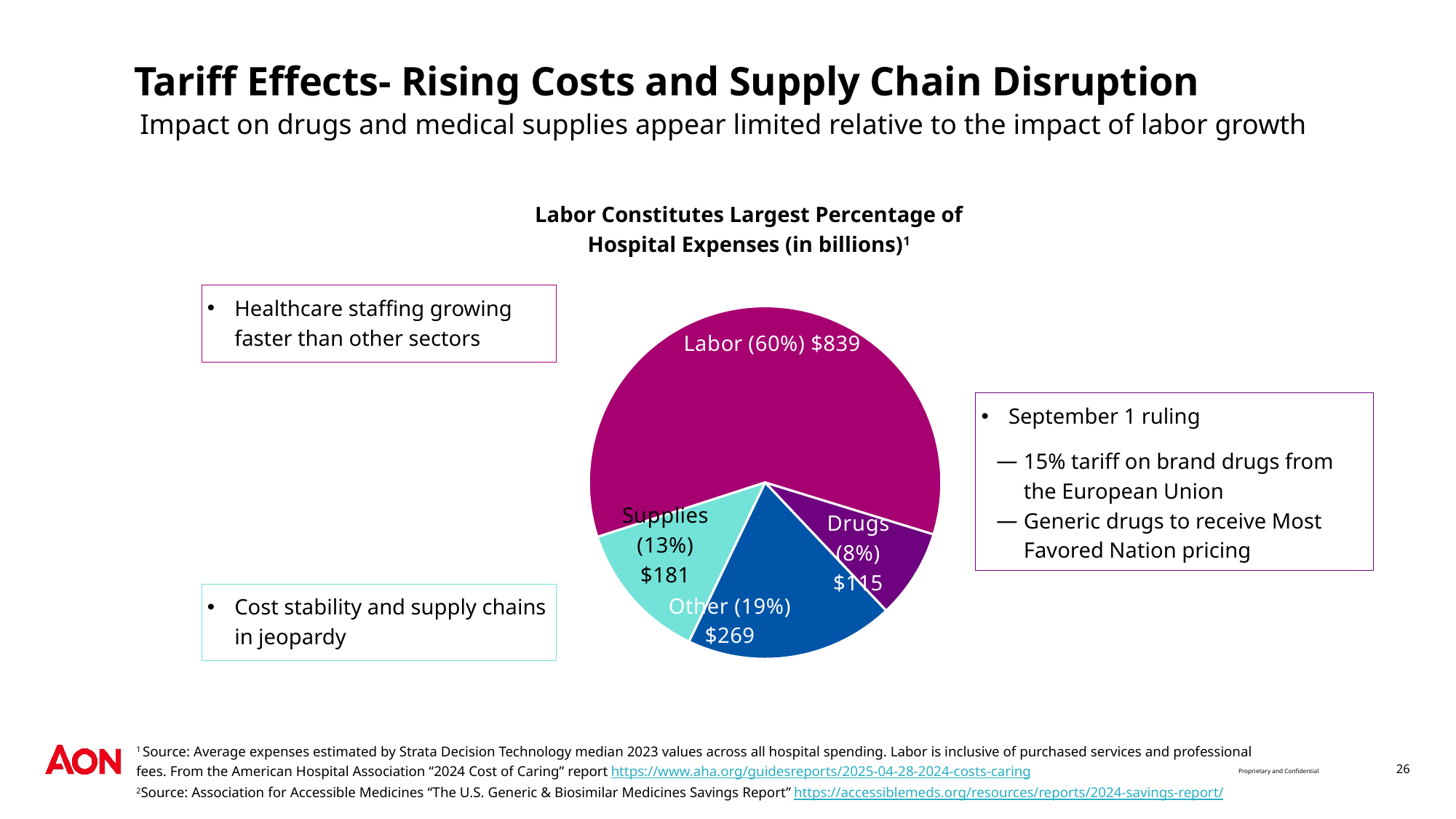
Which is larger, the value for Supplies or the value for Drugs? Supplies What share of the pie does Supplies represent? 13% What is the value for Labor in the pie chart? $839 What is the difference between the Labor value and the Other value? $570 What is the value for Other in the pie chart? $269 Which category has the smallest slice of the pie chart? Drugs Which category has the largest slice of the pie chart? Labor How many categories are shown in the pie chart? 4 What share of the pie does Other represent? 19% What kind of chart is shown on the slide? pie chart What is the value for Supplies in the pie chart? $181 What is the value for Drugs in the pie chart? $115